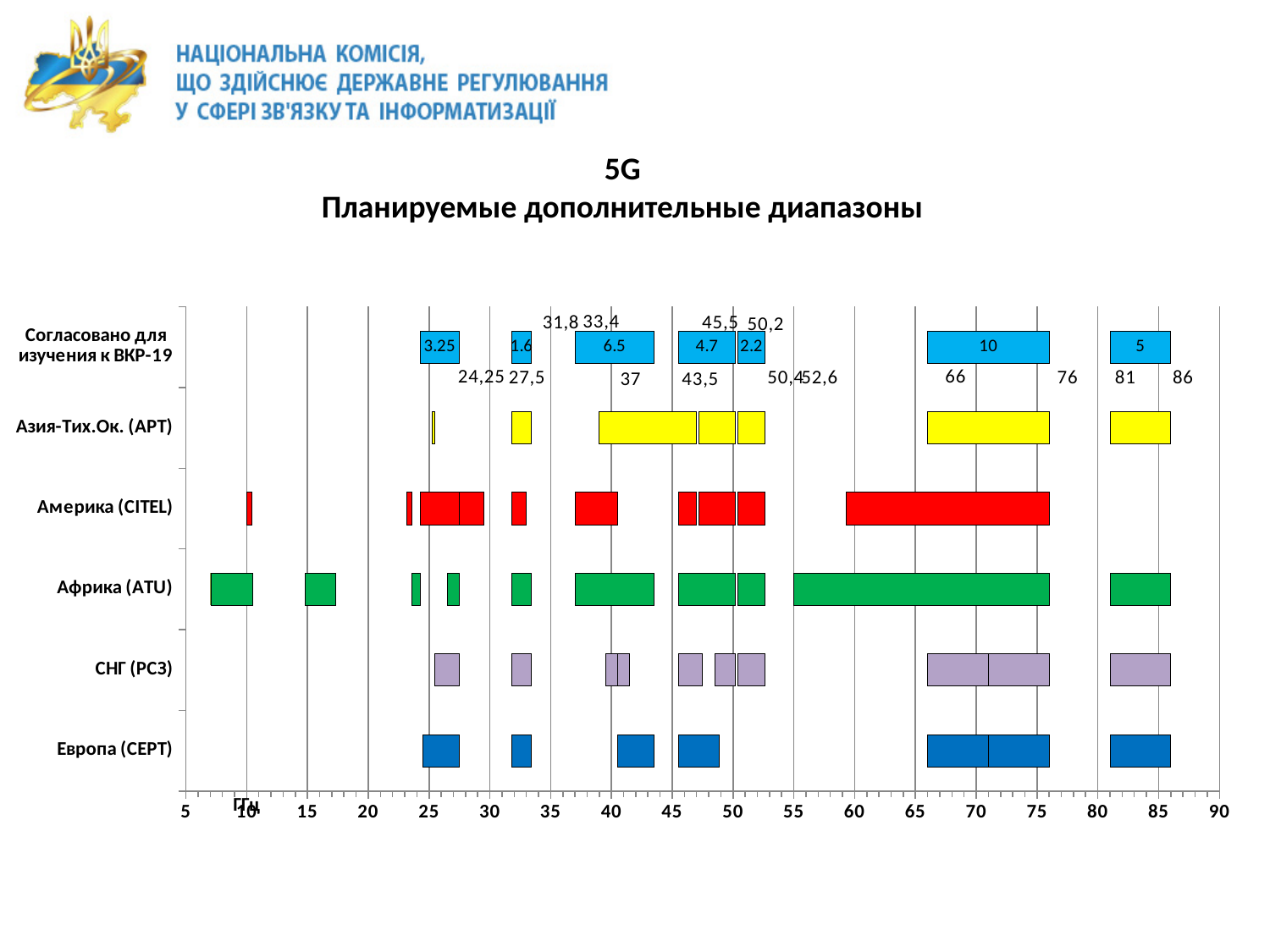
Which labelled band in the row 'Согласовано для изучения к ВКР-19' has the smallest width? 1.6 What is the labelled width of the band between 81 and 86 GHz in the row 'Согласовано для изучения к ВКР-19'? 5 Is the upper edge of the widest band for Африка (ATU) greater or less than 70 GHz? greater What is the labelled width of the band between 66 and 76 GHz in the row 'Согласовано для изучения к ВКР-19'? 10 Is the lower edge of the leftmost band for Африка (ATU) greater or less than 10 GHz? less Which labelled band in the row 'Согласовано для изучения к ВКР-19' has the largest width? 10 What is the difference between the band widths labelled 10 and 5 in the row 'Согласовано для изучения к ВКР-19'? 5 What unit is shown on the horizontal axis of the chart? ГГц In the row 'Согласовано для изучения к ВКР-19', which band is wider: the one labelled 6.5 or the one labelled 4.7? 6.5 What is the title of the chart on the slide? 5G Планируемые дополнительные диапазоны How many regions/categories are listed on the vertical axis of the chart? 6 What kind of chart is shown on the slide? bar chart